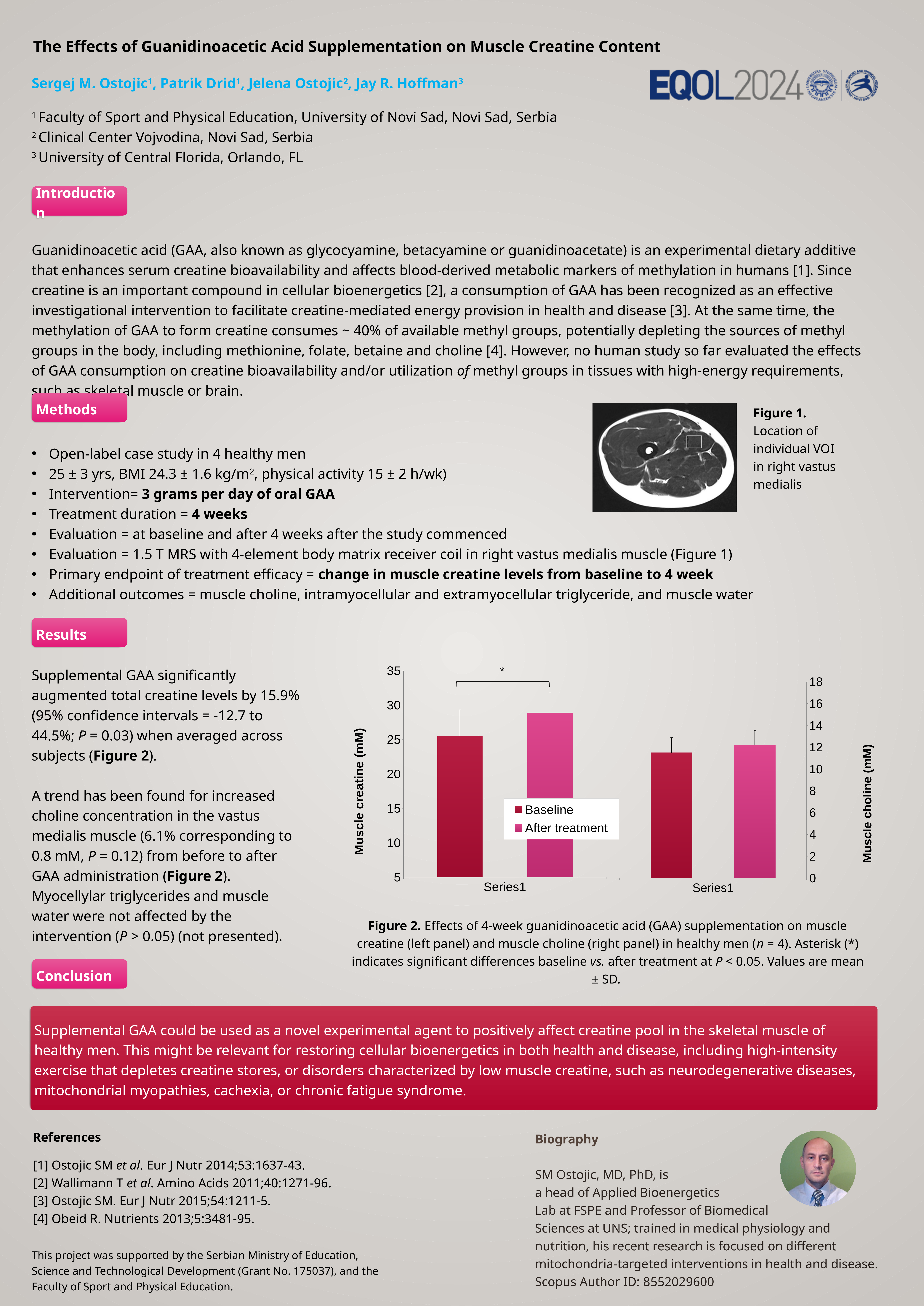
In the left panel of Figure 2 (muscle creatine), is the After treatment value greater or less than 25? greater In the left panel of Figure 2 (muscle creatine), is the Baseline value greater or less than 20? greater In the left panel of Figure 2 (muscle creatine), is the Baseline value greater or less than 30? less How many series does the legend in Figure 2 list? 2 In Figure 2, what is the highest tick value shown on the right vertical axis (muscle choline)? 18 In Figure 2, what is the label of the left vertical axis? Muscle creatine (mM) What kind of chart is Figure 2? bar chart How many bars are plotted in total in Figure 2? 4 What are the two legend entries in Figure 2? Baseline and After treatment In the left panel of Figure 2 (muscle creatine), which bar is taller, Baseline or After treatment? After treatment